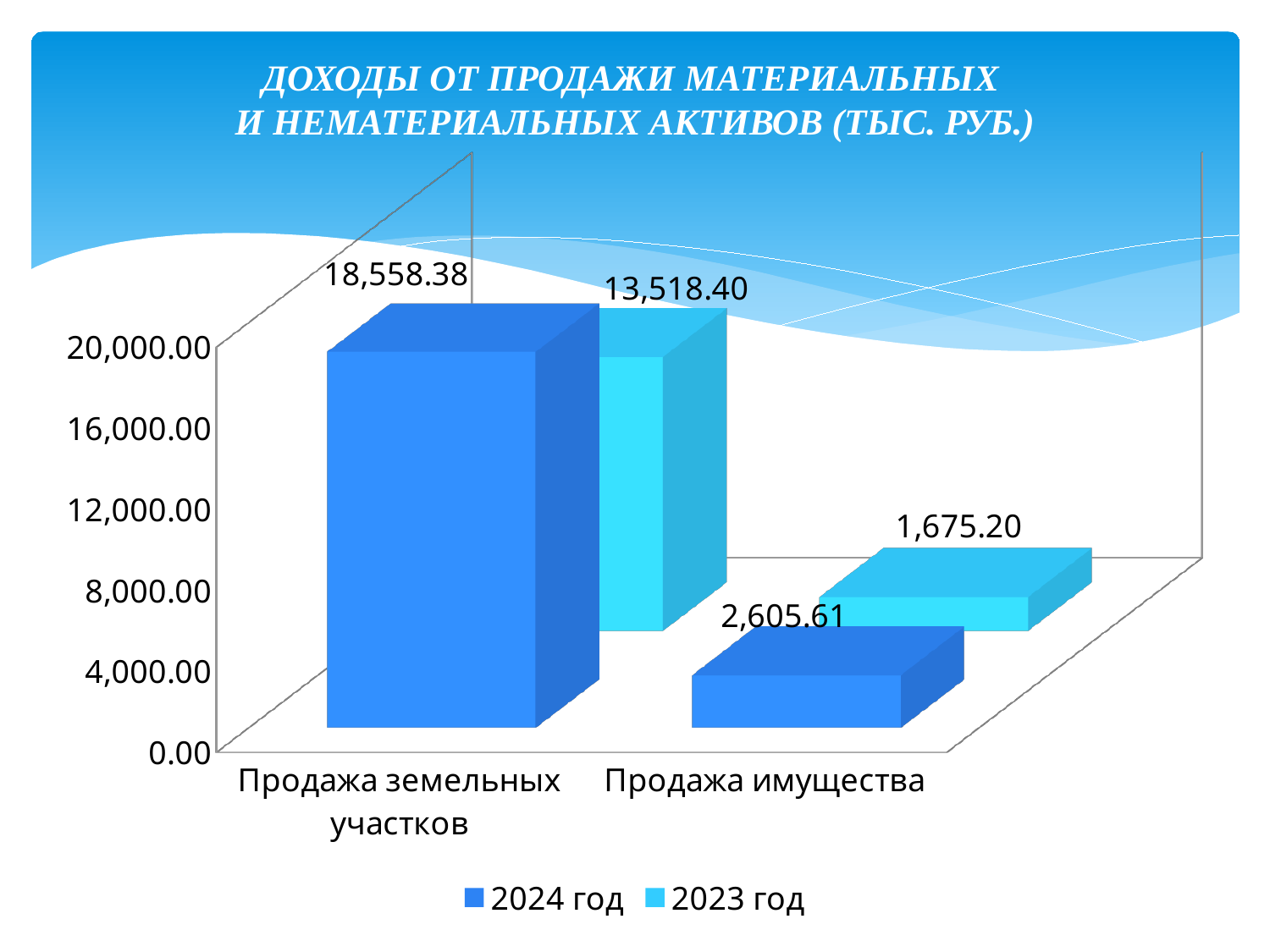
What is the value for Продажа имущества in the 2024 год series? 2,605.61 What is the difference between the 2024 год and 2023 год values for Продажа земельных участков? 5,039.98 What is the value for Продажа имущества in the 2023 год series? 1,675.20 What is the value for Продажа земельных участков in the 2023 год series? 13,518.40 How many categories are shown on the x axis? 2 Which is larger for Продажа имущества: the 2024 год value or the 2023 год value? 2024 год What is the difference between the 2024 год and 2023 год values for Продажа имущества? 930.41 What is the value for Продажа земельных участков in the 2024 год series? 18,558.38 Which category has the highest value in the 2024 год series? Продажа земельных участков What kind of chart is shown on the slide? Bar chart How many series does the legend list? 2 Which category has the lowest value in the 2023 год series? Продажа имущества